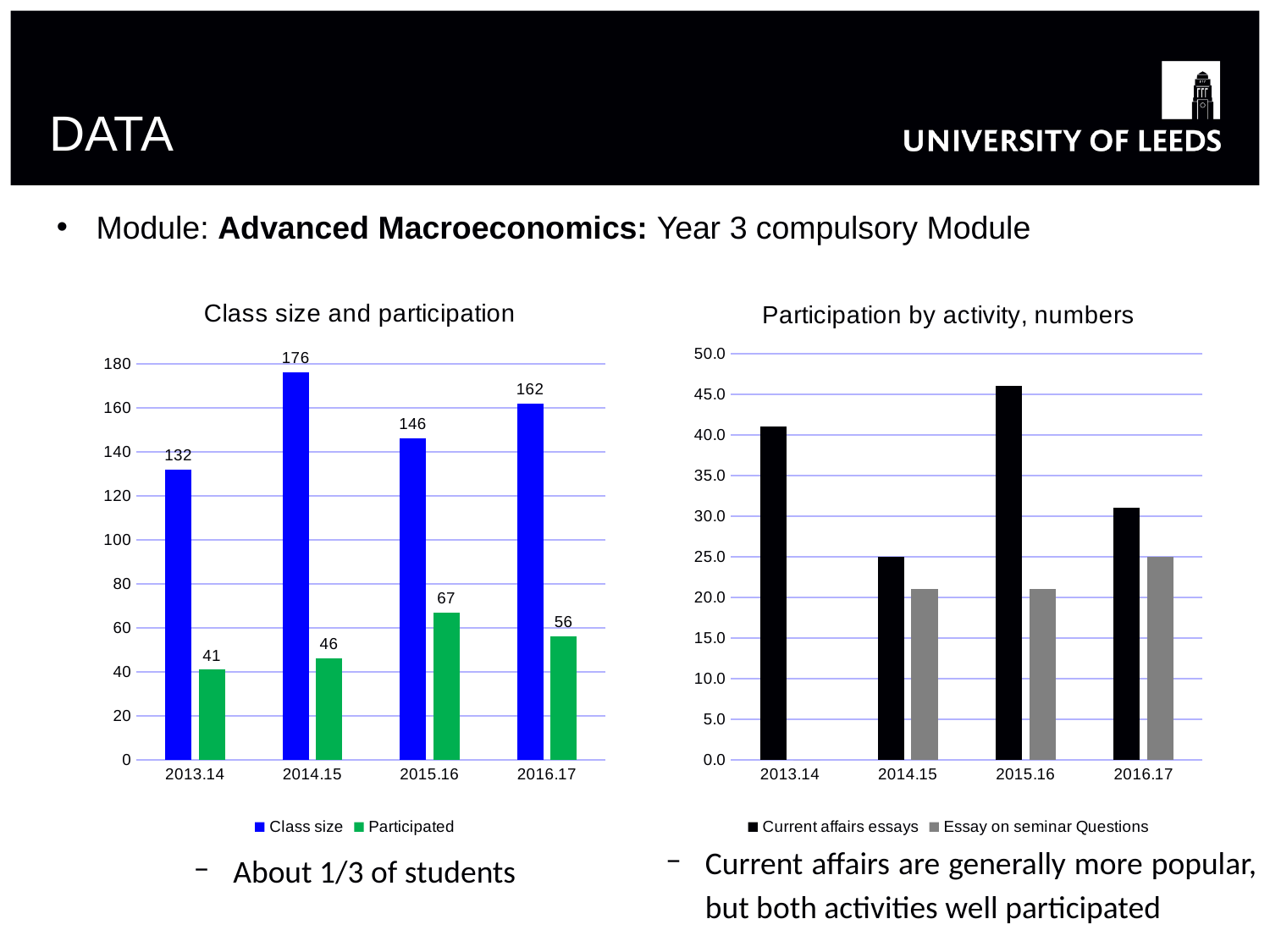
In the 'Participation by activity, numbers' chart, is the value for Essay on seminar Questions in 2014.15 greater or less than 25.0? less In the 'Class size and participation' chart, what is the class size for 2014.15? 176 In the 'Class size and participation' chart, which year has the largest class size? 2014.15 In the 'Participation by activity, numbers' chart, how many years are shown on the x axis? 4 In the 'Participation by activity, numbers' chart, which is larger in 2016.17: Current affairs essays or Essay on seminar Questions? Current affairs essays In the 'Class size and participation' chart, how many series does the legend list? 2 In the 'Class size and participation' chart, what kind of chart is shown? Bar chart In the 'Class size and participation' chart, which year has the lowest number of participants? 2013.14 In the 'Participation by activity, numbers' chart, is the value for Current affairs essays in 2015.16 greater or less than 40.0? greater In the 'Participation by activity, numbers' chart, which year has the highest value for Current affairs essays? 2015.16 In the 'Class size and participation' chart, how many students participated in 2015.16? 67 In the 'Class size and participation' chart, what is the difference between class size and participants in 2016.17? 106